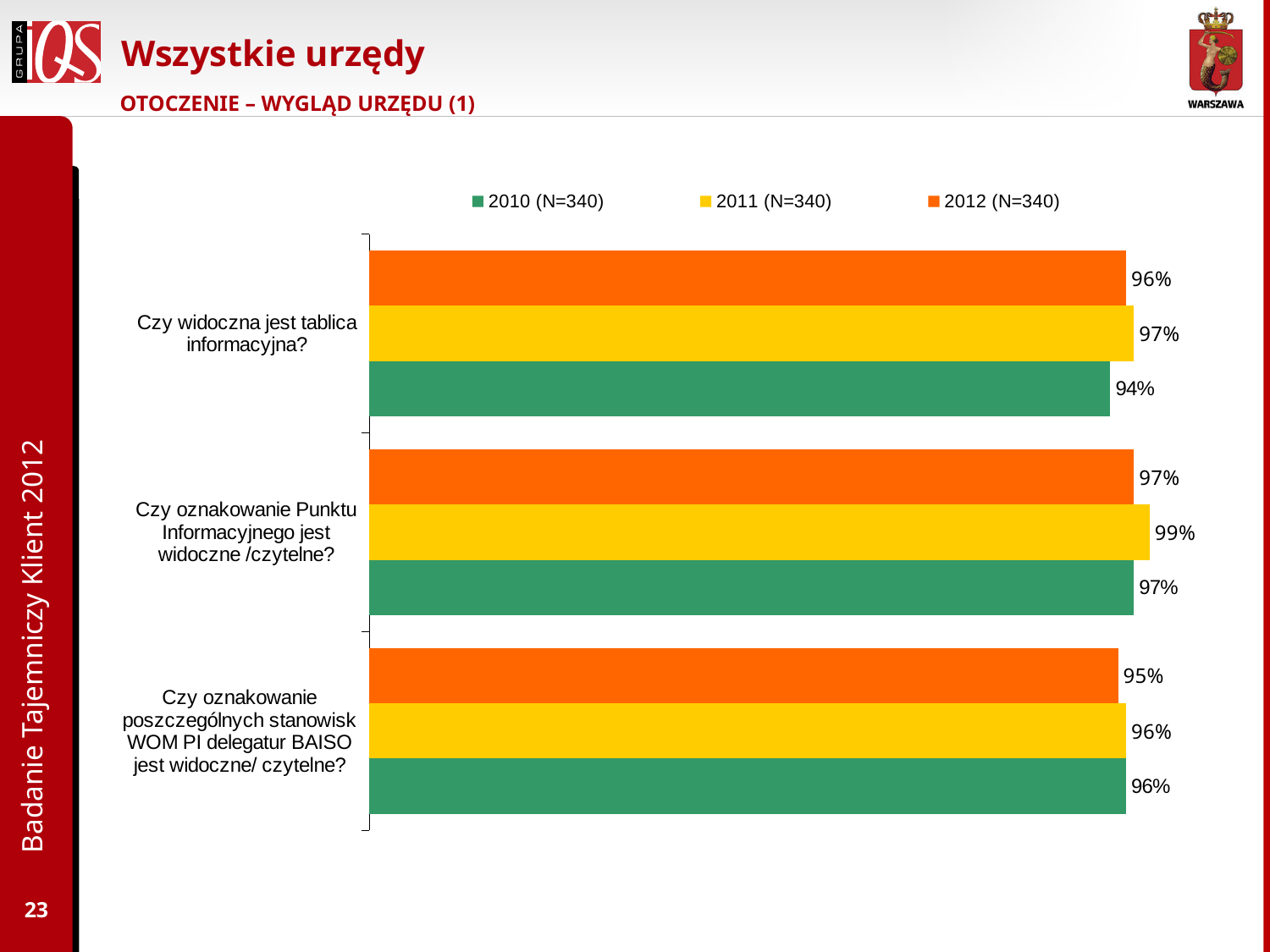
What is the value for 2011 (N=340) for "Czy oznakowanie Punktu Informacyjnego jest widoczne /czytelne?"? 99% What is the value for 2012 (N=340) for "Czy widoczna jest tablica informacyjna?"? 96% How many series does the legend list? 3 What is the difference between the 2011 and 2010 values for "Czy widoczna jest tablica informacyjna?"? 3% For "Czy oznakowanie poszczególnych stanowisk WOM PI delegatur BAISO jest widoczne/ czytelne?", which is larger: the 2011 value or the 2012 value? 2011 (N=340) How many question categories are shown on the chart? 3 What kind of chart is shown on the slide? Bar chart What is the value for 2010 (N=340) for "Czy widoczna jest tablica informacyjna?"? 94% Which year has the lowest value for "Czy widoczna jest tablica informacyjna?"? 2010 (N=340) What is the difference between the 2011 and 2012 values for "Czy oznakowanie Punktu Informacyjnego jest widoczne /czytelne?"? 2% Which year has the highest value for "Czy oznakowanie Punktu Informacyjnego jest widoczne /czytelne?"? 2011 (N=340) What is the value for 2012 (N=340) for "Czy oznakowanie poszczególnych stanowisk WOM PI delegatur BAISO jest widoczne/ czytelne?"? 95%